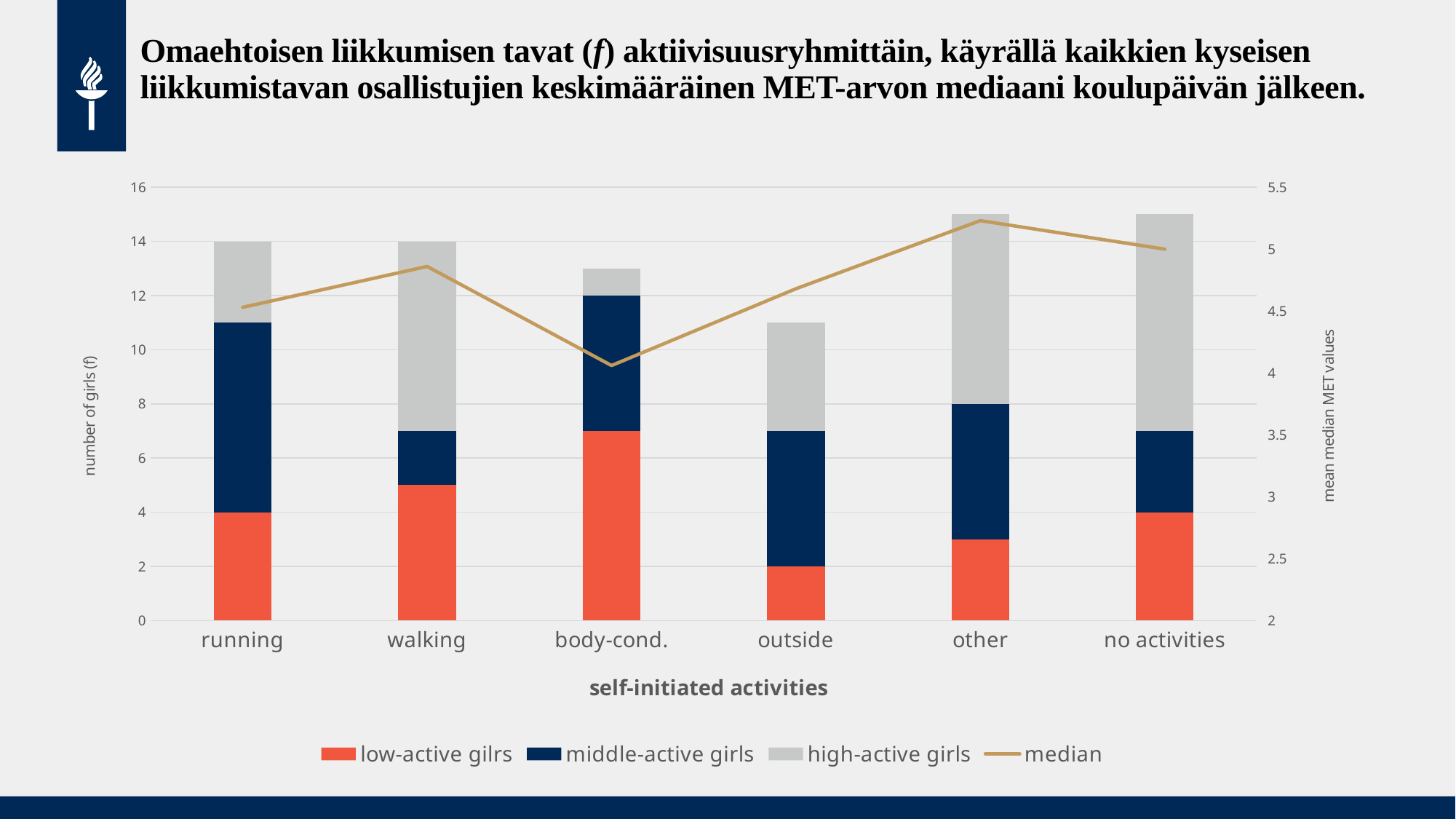
What type of chart is shown on the slide? A stacked bar chart combined with a line How many series does the legend list? 4 What is the total number of girls for the running bar? 14 Which activity has the lowest median MET value on the line? body-cond. Is the median MET value for body-cond. greater or less than 4.5? less How many low-active girls are shown for outside? 2 Which activity has the highest median MET value on the line? other Which activity has the lowest total number of girls? outside Is the total number of girls for other greater or less than 14? greater What is the total number of girls for the walking bar? 14 How many low-active girls are shown for running? 4 How many self-initiated activity categories are shown on the x axis? 6